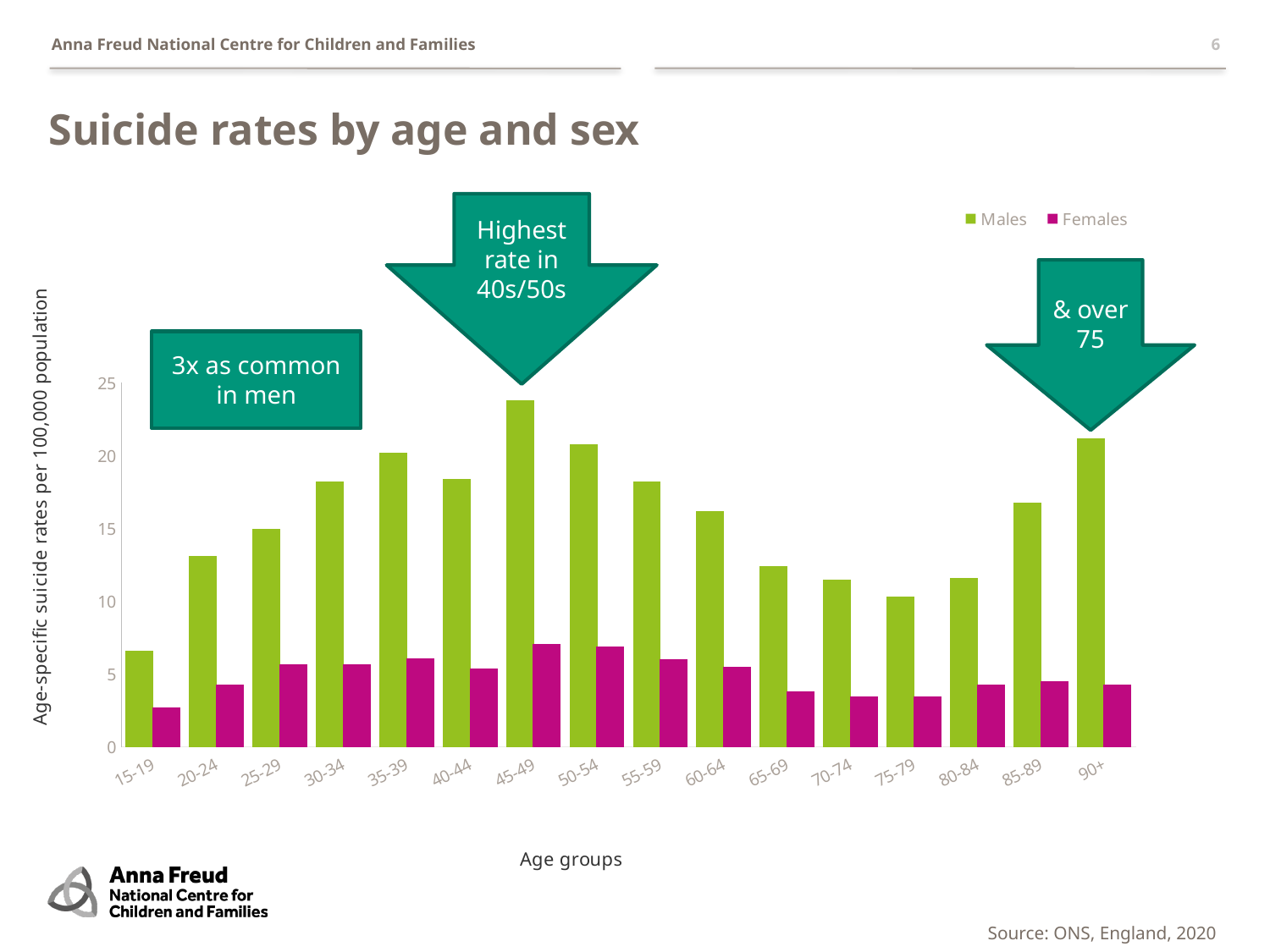
What kind of chart is shown on the slide? bar chart How many series does the legend list? 2 What is the title of the chart? Suicide rates by age and sex Which is larger, the Females value for 60-64 or the Females value for 65-69? 60-64 How many age groups are shown on the x axis? 16 Which age group has the lowest suicide rate for Males? 15-19 Which age group has the highest suicide rate for Males? 45-49 Is the Males value for the 30-34 age group greater or less than 20? less Is the Males value for the 45-49 age group greater or less than 20? greater Is the Females value for the 15-19 age group greater or less than 5? less Which age group has the lowest suicide rate for Females? 15-19 Which is larger, the Males value for 45-49 or the Males value for 50-54? 45-49